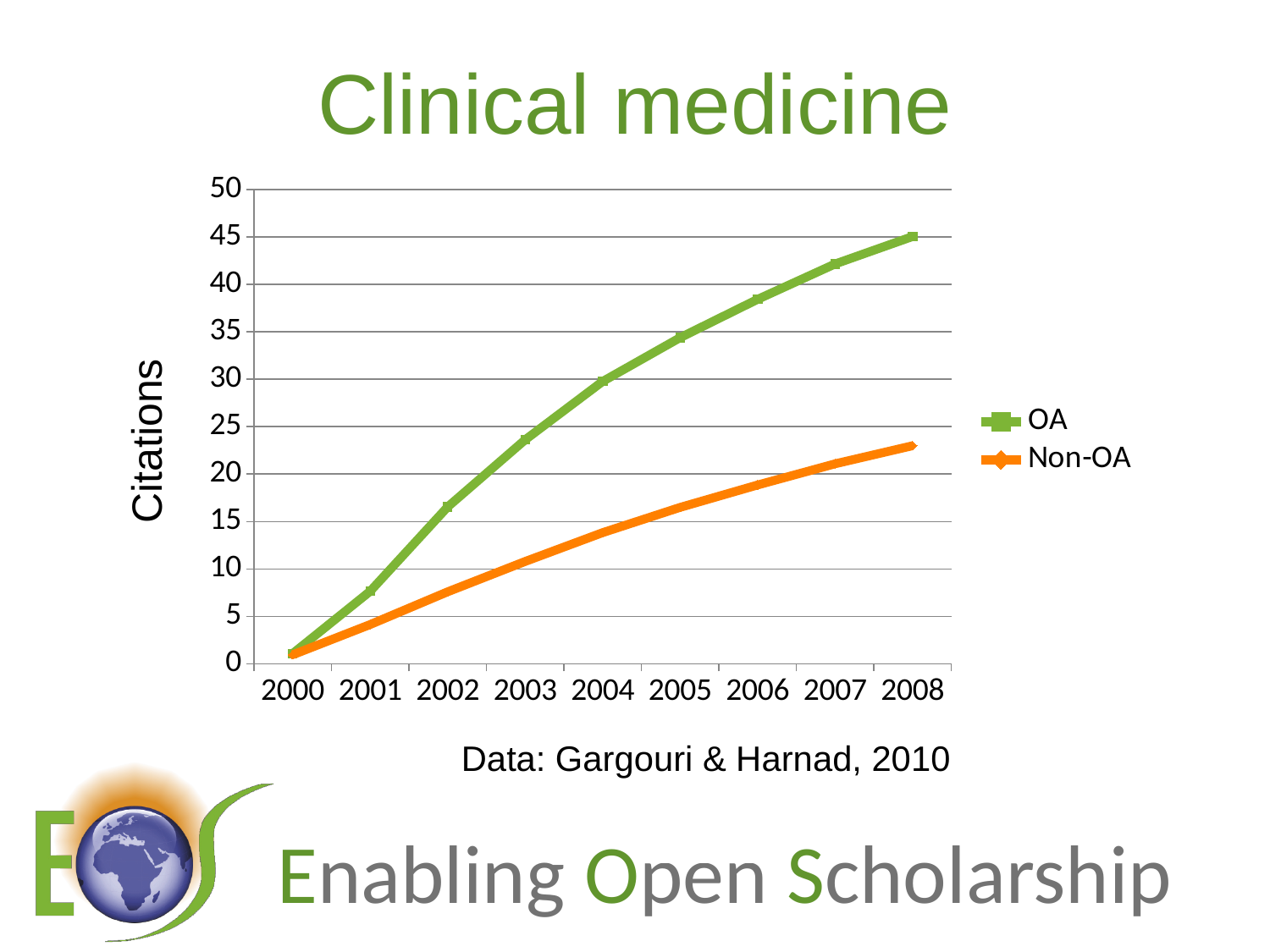
Is the OA value for 2008 greater or less than 40? greater What is the label on the y axis? Citations What kind of chart is shown on the slide? line chart In 2008, which series has more citations, OA or Non-OA? OA How many series does the legend list? 2 In which year does the OA series reach its highest value? 2008 Is the OA value for 2003 greater or less than 20? greater Is the Non-OA value for 2004 greater or less than 20? less Do the Non-OA citations rise or fall from 2000 to 2008? rise How many years are shown along the x axis? 9 Do the OA citations rise or fall from 2000 to 2008? rise